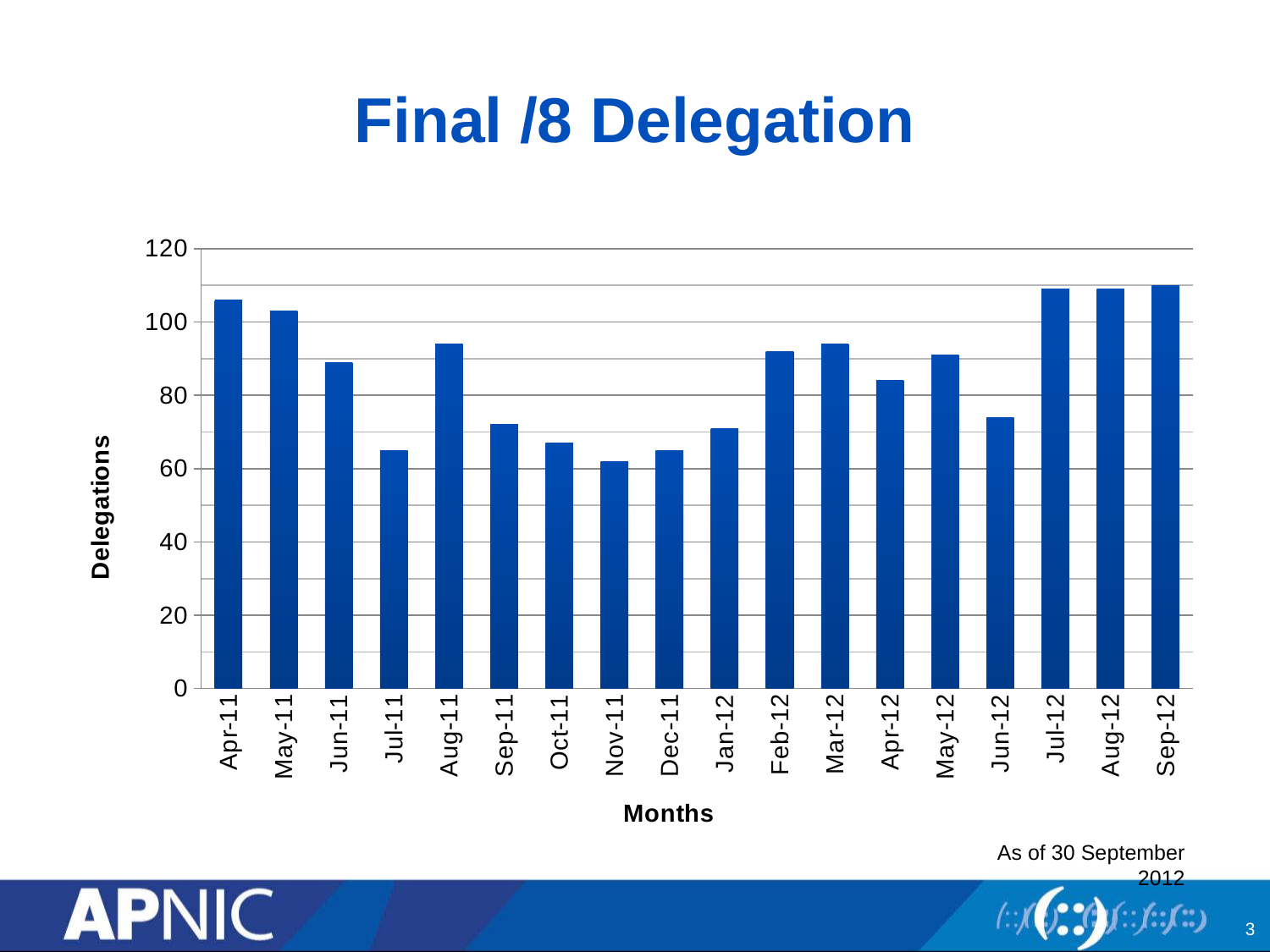
Is the value for Jul-11 greater or less than 80? less Is the value for Jun-11 greater or less than 100? less How many months are plotted on the x axis? 18 Which has a higher value, Apr-11 or Jul-11? Apr-11 What is the label on the y axis? Delegations Is the value for Sep-12 greater or less than 100? greater What kind of chart is shown on the slide? bar chart Do the values rise or fall from Apr-11 to Jul-11? fall What is the title of the chart? Final /8 Delegation Which has a higher value, Feb-12 or Jun-12? Feb-12